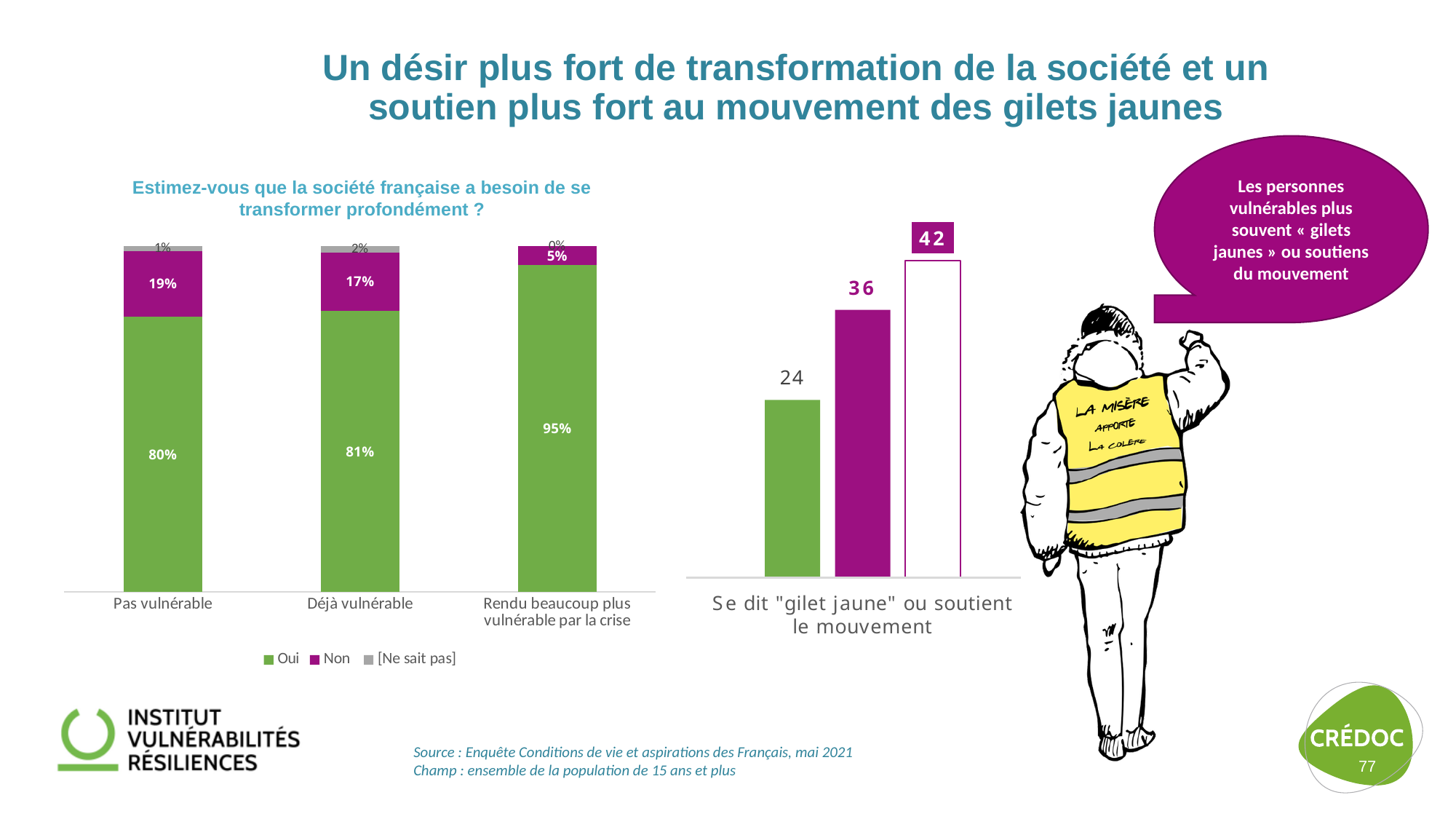
In the left chart, what is the 'Oui' value for 'Rendu beaucoup plus vulnérable par la crise'? 95% In the right chart ('Se dit "gilet jaune" ou soutient le mouvement'), what is the value of the tallest bar? 42 In the left chart, what percentage of 'Pas vulnérable' respondents answered 'Oui'? 80% In the right chart ('Se dit "gilet jaune" ou soutient le mouvement'), what is the value of the green bar? 24 How many categories are shown on the x axis of the left chart? 3 In the left chart, what is the difference between the 'Oui' share for 'Rendu beaucoup plus vulnérable par la crise' and for 'Pas vulnérable'? 15 percentage points In the right chart ('Se dit "gilet jaune" ou soutient le mouvement'), what is the difference between the highest and lowest bar values? 18 How many series does the legend of the left chart list? 3 In the left chart, what percentage of 'Déjà vulnérable' respondents answered 'Non'? 17% What kind of chart is the left chart? Stacked bar chart In the left chart, which category has the lowest 'Non' share? Rendu beaucoup plus vulnérable par la crise In the left chart, which category has the highest 'Oui' share? Rendu beaucoup plus vulnérable par la crise